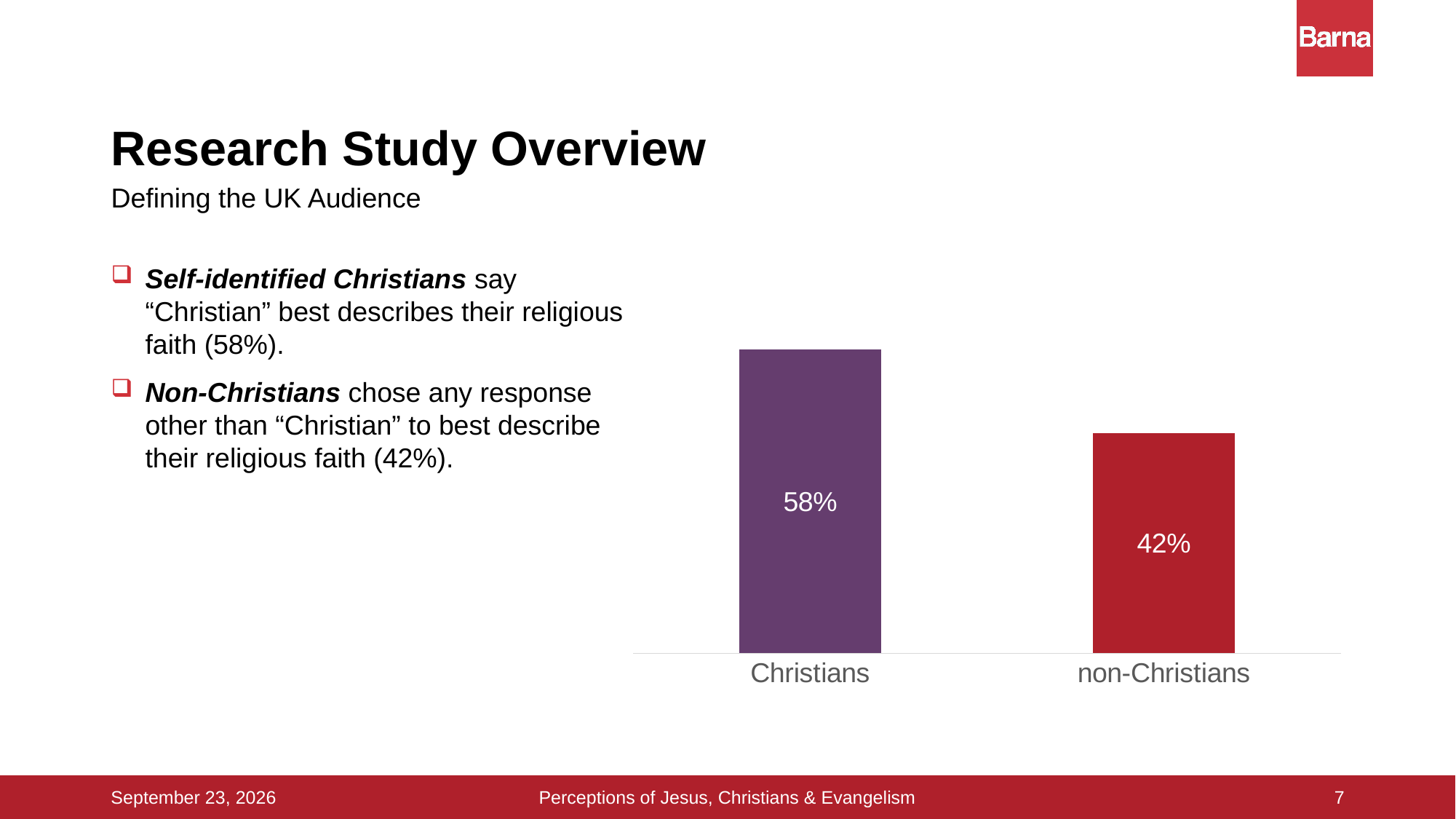
What colour is the bar for non-Christians? Red Which category has the highest value? Christians What is the total of the two bar values? 100% What is the value for Christians? 58% What is the value for non-Christians? 42% What is the difference between the values for Christians and non-Christians? 16% What kind of chart is shown on the slide? Bar chart How many categories are shown in the chart? 2 What colour is the bar for Christians? Purple Which category has the lowest value? non-Christians Do the values rise or fall from left to right across the categories? Fall Which is larger, the value for Christians or the value for non-Christians? Christians